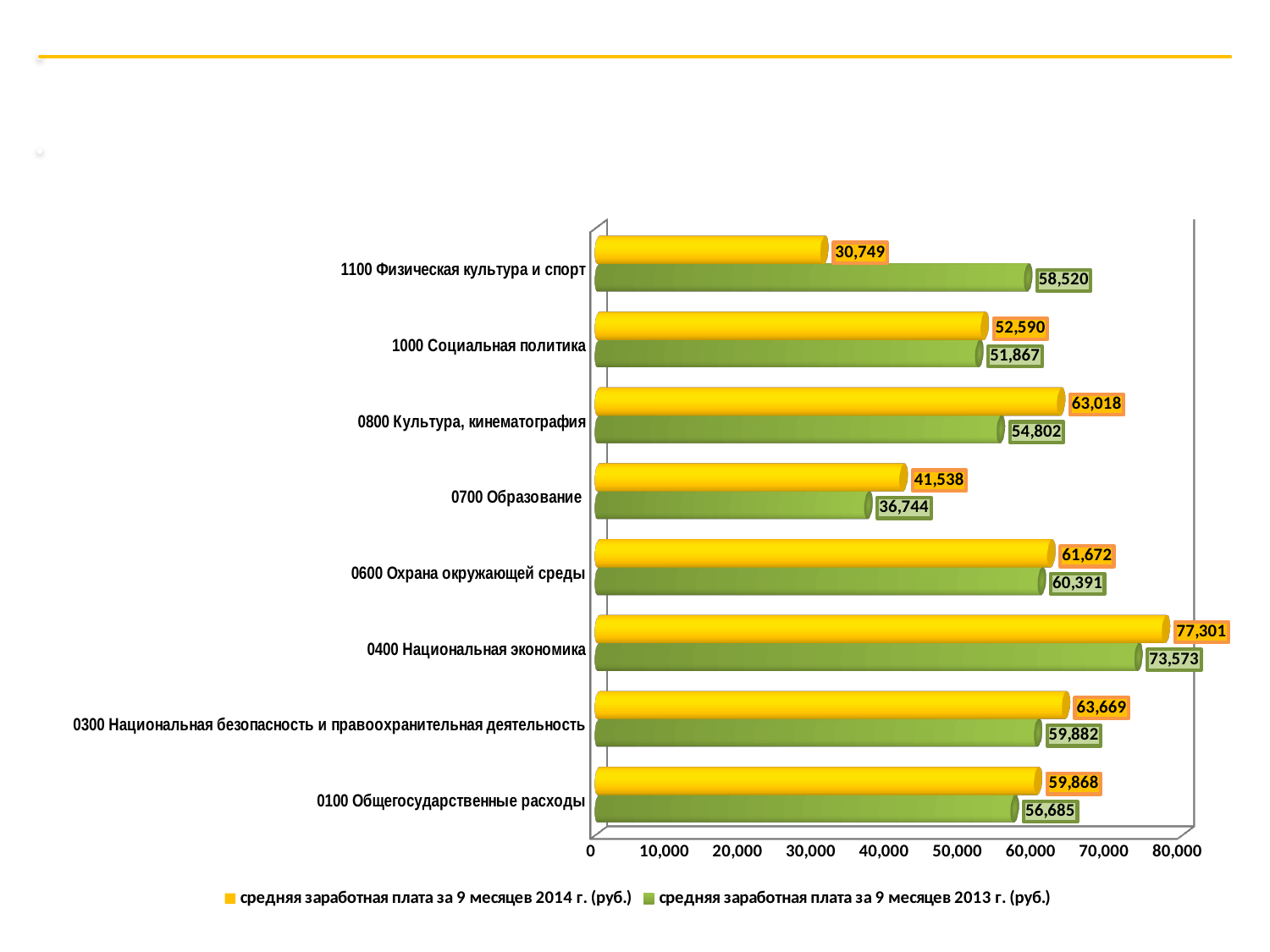
What is the average salary for 9 months of 2014 for 0400 Национальная экономика? 77,301 Which category has the lowest average salary for 9 months of 2014? 1100 Физическая культура и спорт How many categories are shown on the chart? 8 Which category has the highest average salary for 9 months of 2014? 0400 Национальная экономика What is the difference between the 2014 and 2013 values for 0400 Национальная экономика? 3,728 What kind of chart is shown on the slide? Bar chart What is the average salary for 9 months of 2013 for 1100 Физическая культура и спорт? 58,520 What is the value for 0700 Образование in the 2014 series? 41,538 Which category has the lowest average salary for 9 months of 2013? 0700 Образование How many series does the legend list? 2 For 0800 Культура, кинематография, which is larger: the 2014 value or the 2013 value? 2014 value (63,018) What is the difference between the 2013 and 2014 values for 1100 Физическая культура и спорт? 27,771